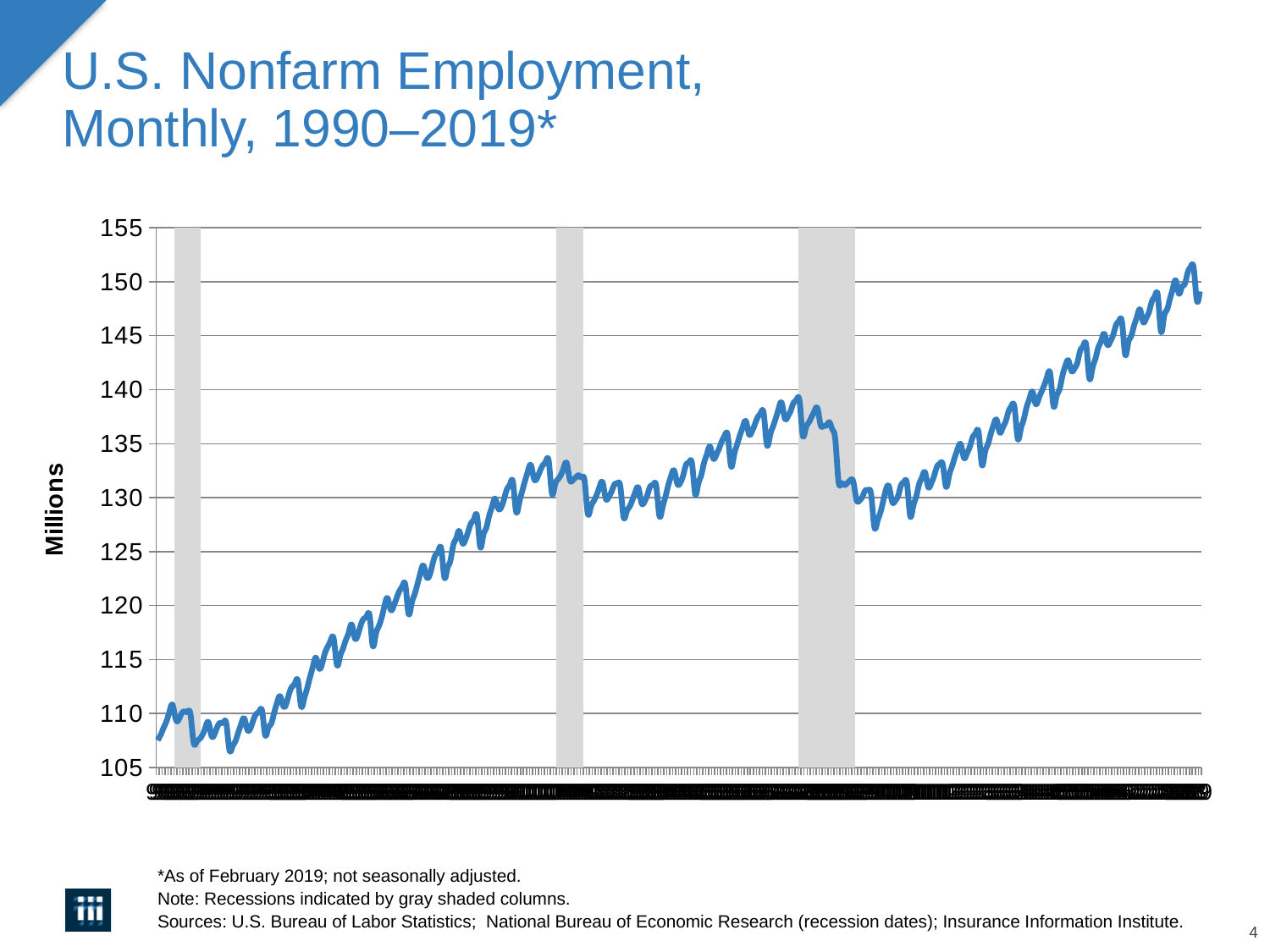
Overall, does U.S. nonfarm employment rise or fall from 1990 to 2019 on the chart? rise What kind of chart is shown on the slide? line chart What is the label on the vertical axis of the chart? Millions Is the value at the end of the series in early 2019 greater or less than 145? greater Is the lowest value on the chart greater or less than 110? less Is the highest value on the chart greater or less than 145? greater Does the line rise or fall during the third (rightmost) gray shaded recession column? fall How many gray shaded recession columns are shown on the chart? 3